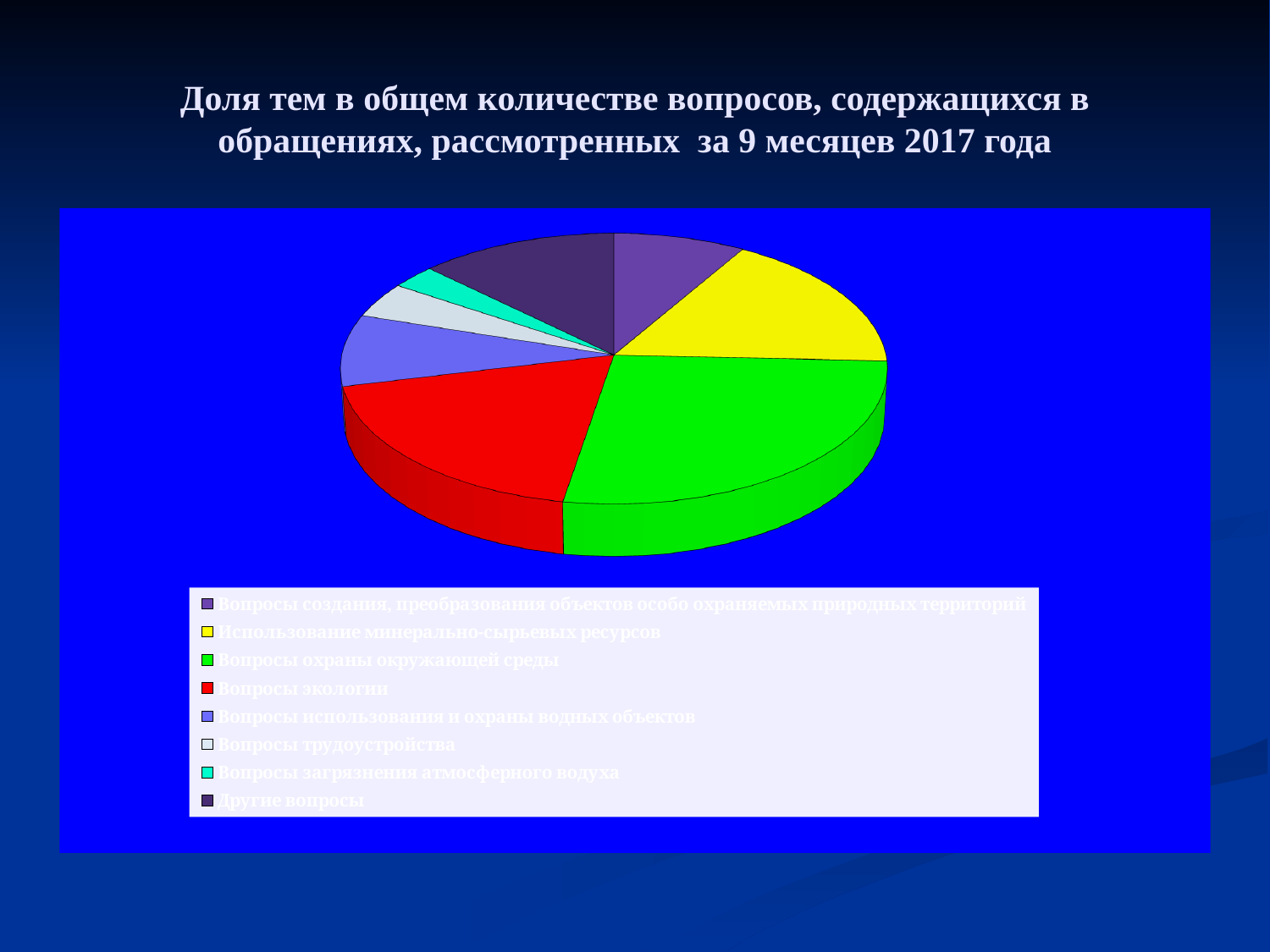
Which slice is larger: Вопросы экологии or Вопросы создания, преобразования объектов особо охраняемых природных территорий? Вопросы экологии What colour is the slice for Вопросы экологии? red Which category has the largest slice of the pie? Вопросы охраны окружающей среды What kind of chart is shown on the slide? pie chart Which slice is larger: Вопросы охраны окружающей среды or Использование минерально-сырьевых ресурсов? Вопросы охраны окружающей среды Which slice is larger: Другие вопросы or Вопросы трудоустройства? Другие вопросы What is the title of the chart on the slide? Доля тем в общем количестве вопросов, содержащихся в обращениях, рассмотренных за 9 месяцев 2017 года How many categories (slices) does the pie chart have? 8